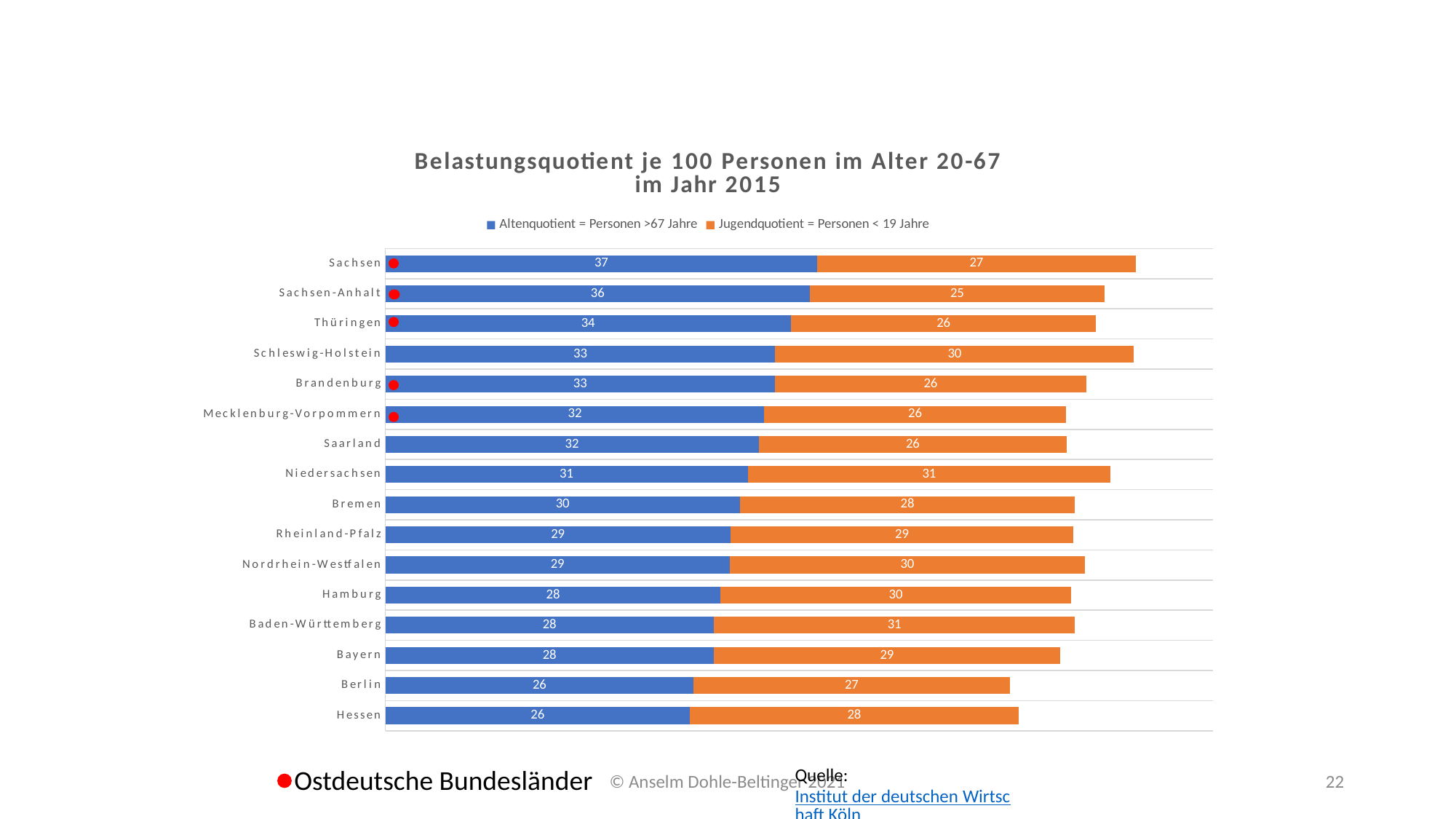
What is the total of the stacked bar for Sachsen? 64 What kind of chart is shown on the slide? Stacked bar chart Which is larger, the Altenquotient of Thüringen or the Altenquotient of Bremen? Thüringen What does the red dot next to a Bundesland name indicate? Ostdeutsche Bundesländer What is the Jugendquotient value for Niedersachsen? 31 What is the difference between the Altenquotient of Sachsen and that of Hessen? 11 Which Bundesland has the lowest Jugendquotient? Sachsen-Anhalt Which Bundesland has the highest Altenquotient? Sachsen How many series does the legend list? 2 What is the total of the stacked bar for Berlin? 53 How many Bundesländer are shown in the chart? 16 What is the Altenquotient value for Sachsen? 37